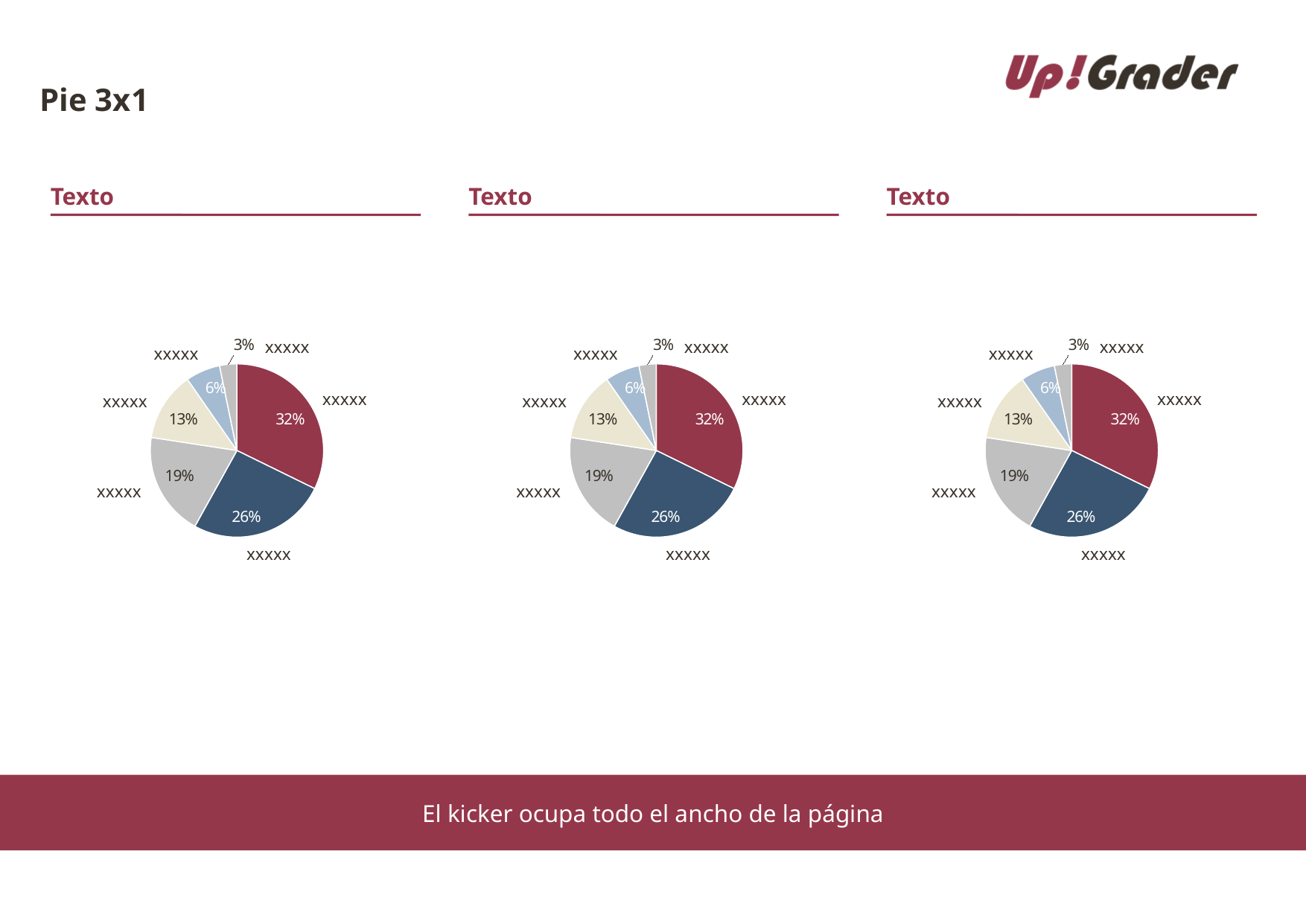
In the right pie chart, what is the difference between the largest slice (32%) and the smallest slice (3%)? 29 percentage points How many slices does the left pie chart have? 6 In the right pie chart, what percentage is shown on the dark red slice? 32% How many pie charts are shown on the slide? 3 In the left pie chart, what is the combined share of the 32% and 26% slices? 58% In the middle pie chart, which is larger: the grey slice at 19% or the beige slice at 13%? the grey slice at 19% In the left pie chart, what is the largest slice's percentage? 32% What kind of chart is the left chart on the slide? pie chart In the left pie chart, what percentage is shown on the light blue slice? 6% In the middle pie chart, what is the smallest slice's percentage? 3% In the middle pie chart, what percentage is shown on the dark blue slice? 26% What is the heading text above each of the three pie charts? Texto